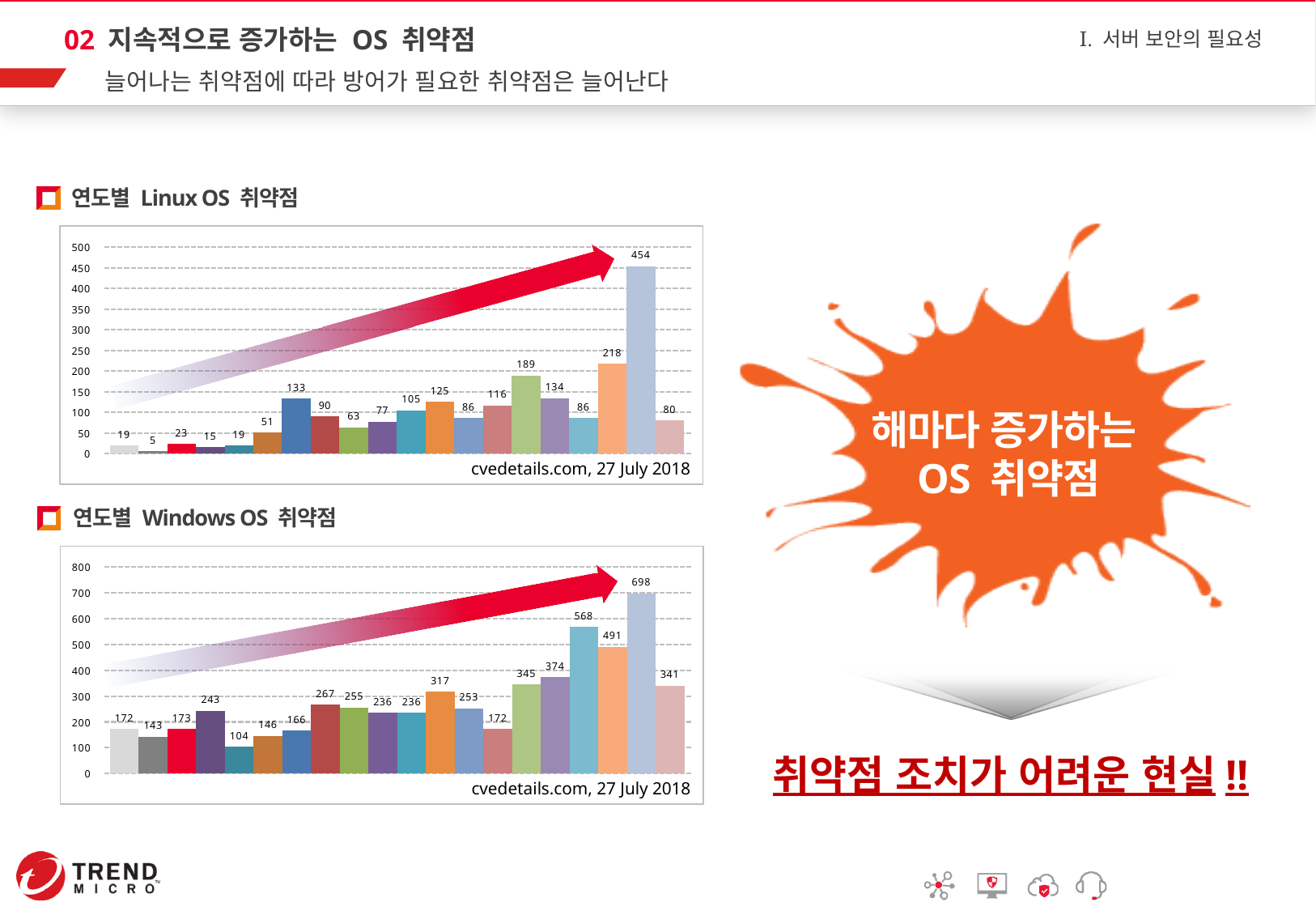
In the '연도별 Linux OS 취약점' chart, what is the lowest value shown on any bar? 5 In the '연도별 Windows OS 취약점' chart, what is the value of the first (leftmost) bar? 172 What data source is cited below both charts? cvedetails.com, 27 July 2018 In the '연도별 Windows OS 취약점' chart, what is the lowest value shown on any bar? 104 In the '연도별 Linux OS 취약점' chart, what is the highest value shown on any bar? 454 What kind of chart is the '연도별 Windows OS 취약점' chart? Bar chart In the '연도별 Linux OS 취약점' chart, what is the value of the last (rightmost) bar? 80 In the '연도별 Windows OS 취약점' chart, what is the highest value shown on any bar? 698 In the '연도별 Windows OS 취약점' chart, what is the difference between the tallest bar (698) and the rightmost bar (341)? 357 In the '연도별 Linux OS 취약점' chart, what is the difference between the tallest bar (454) and the second-tallest bar (218)? 236 How many bars are plotted in the '연도별 Linux OS 취약점' chart? 20 Which chart has the higher maximum value, the Linux OS chart or the Windows OS chart? Windows OS chart